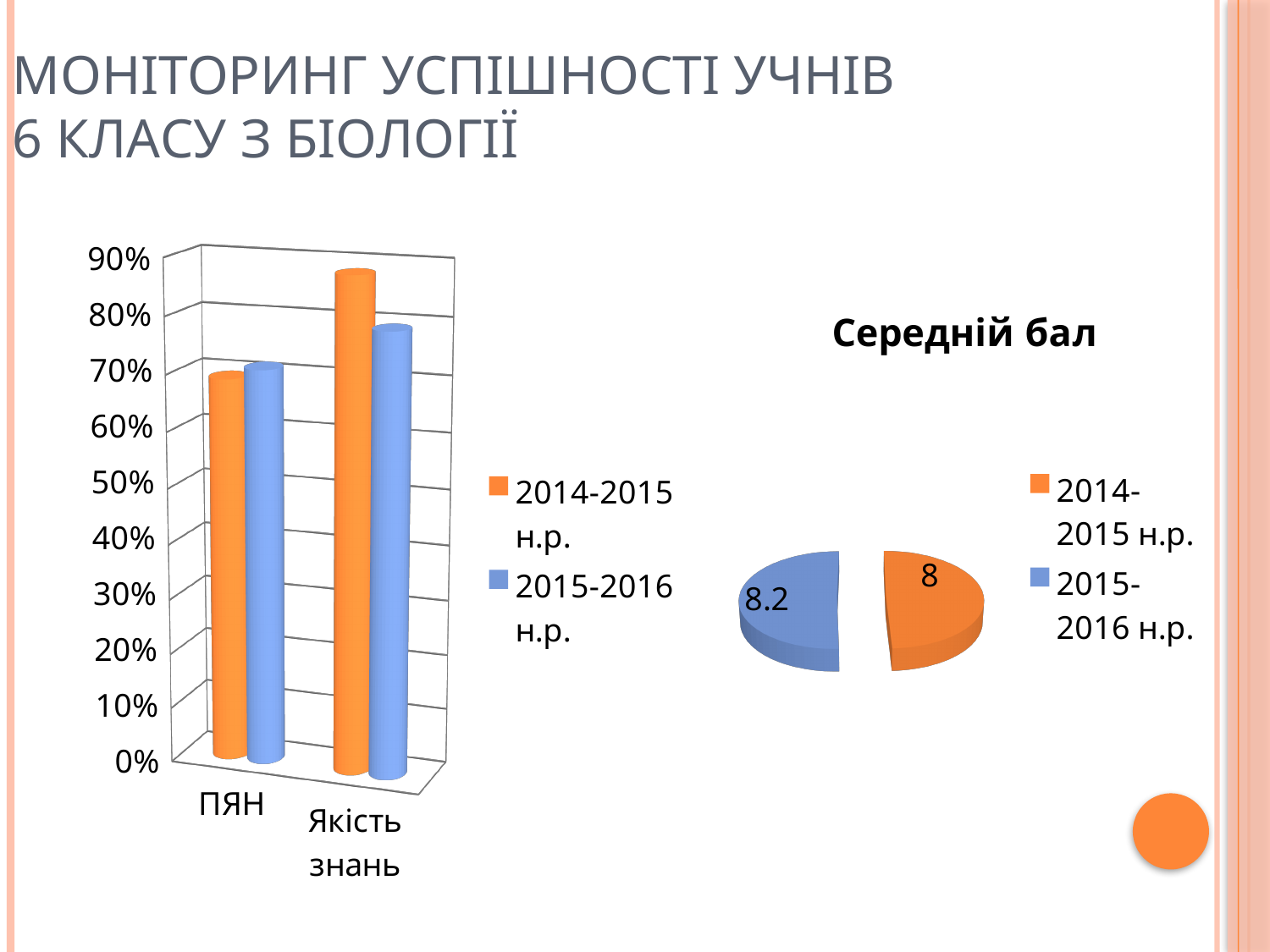
What kind of chart is the chart on the left of the slide? bar chart How many categories are shown on the x axis of the bar chart on the left? 2 In the bar chart on the left, is the value for Якість знань in 2015-2016 н.р. greater or less than 70%? greater How many slices does the chart titled "Середній бал" have? 2 What kind of chart is the chart titled "Середній бал"? pie chart In the chart titled "Середній бал", what is the difference between the values for 2015-2016 н.р. and 2014-2015 н.р.? 0.2 In the chart titled "Середній бал", what is the value for 2015-2016 н.р.? 8.2 In the bar chart on the left, which series has the larger value for Якість знань, 2014-2015 н.р. or 2015-2016 н.р.? 2014-2015 н.р. In the chart titled "Середній бал", which year has the larger value, 2014-2015 н.р. or 2015-2016 н.р.? 2015-2016 н.р. In the bar chart on the left, is the value for Якість знань in 2014-2015 н.р. greater or less than 80%? greater How many series does the legend of the bar chart on the left list? 2 In the chart titled "Середній бал", what is the value for 2014-2015 н.р.? 8